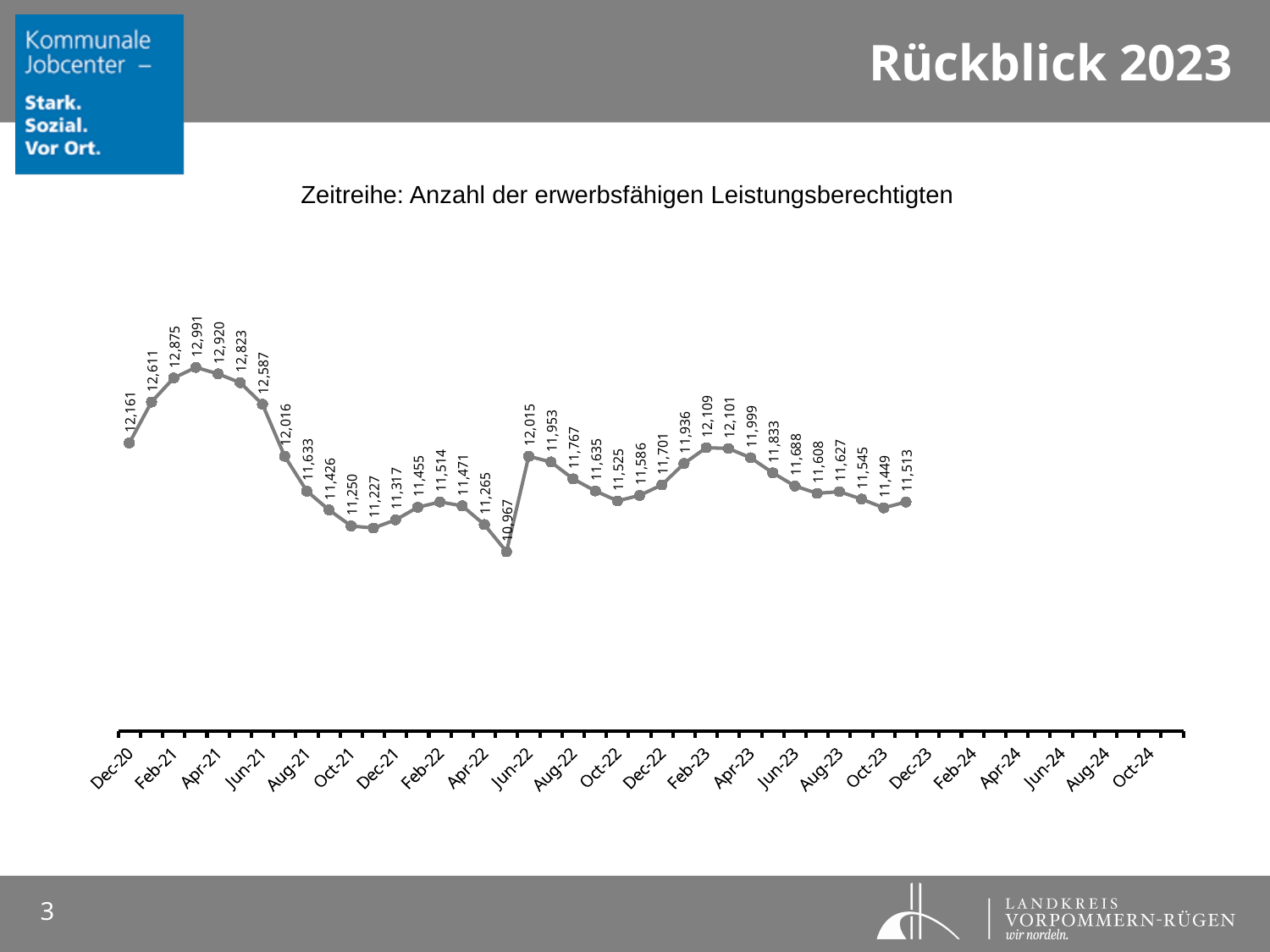
What is the difference between the values for Feb-23 and Feb-22? 595 What kind of chart is shown on the slide? line chart What is the highest value plotted on the chart? 12,991 What is the lowest value plotted on the chart? 10,967 What is the title of the chart? Zeitreihe: Anzahl der erwerbsfähigen Leistungsberechtigten What is the value for Feb-23? 12,109 Which is larger, the value for Jun-22 or the value for Jun-23? Jun-22 What is the difference between the values for Dec-20 and Oct-23? 712 Do the values rise or fall from Feb-21 to Oct-21? fall What is the value for Jun-22? 12,015 What is the value for Oct-23? 11,449 What is the value for Dec-20? 12,161